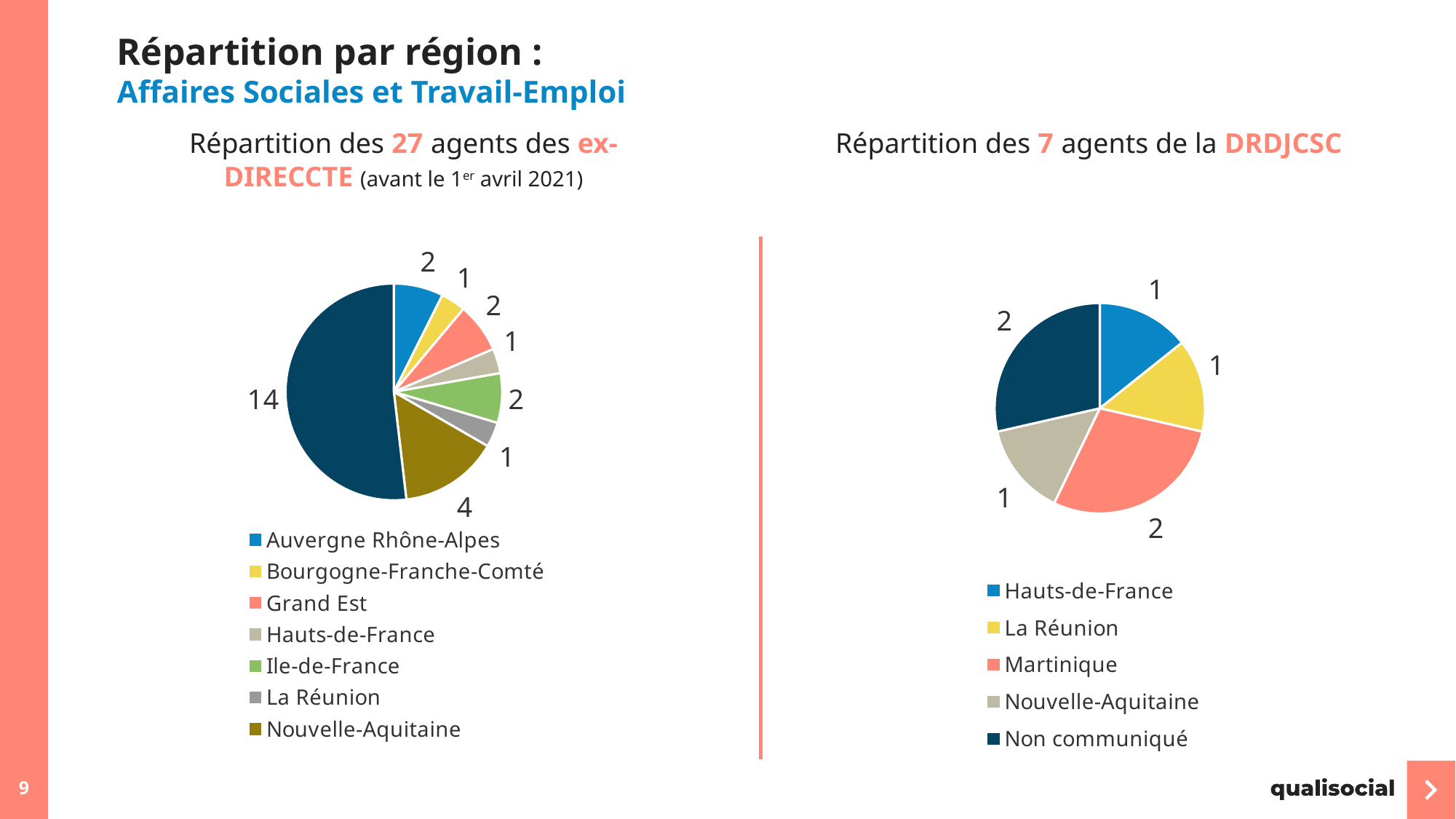
In the left pie chart (ex-DIRECCTE), how many agents are in Nouvelle-Aquitaine? 4 In the left pie chart (ex-DIRECCTE), how many entries does the legend list? 7 In the right pie chart (DRDJCSC), how many agents are in the 'Non communiqué' category? 2 In the right pie chart (DRDJCSC), which has more agents, Martinique or Hauts-de-France? Martinique In the left pie chart (ex-DIRECCTE), how many agents are in Bourgogne-Franche-Comté? 1 In the right pie chart (DRDJCSC), how many slices does the pie have? 5 In the right pie chart (DRDJCSC), how many agents are in Martinique? 2 In the left pie chart (ex-DIRECCTE), how many agents are in Grand Est? 2 What type of chart is used on the right side of the slide (DRDJCSC)? Pie chart In the left pie chart (ex-DIRECCTE), what is the difference between the number of agents in Nouvelle-Aquitaine and in Ile-de-France? 2 In the left pie chart (ex-DIRECCTE), what is the value of the largest slice? 14 In the left pie chart (ex-DIRECCTE), among the regions listed in the legend, which has the most agents? Nouvelle-Aquitaine